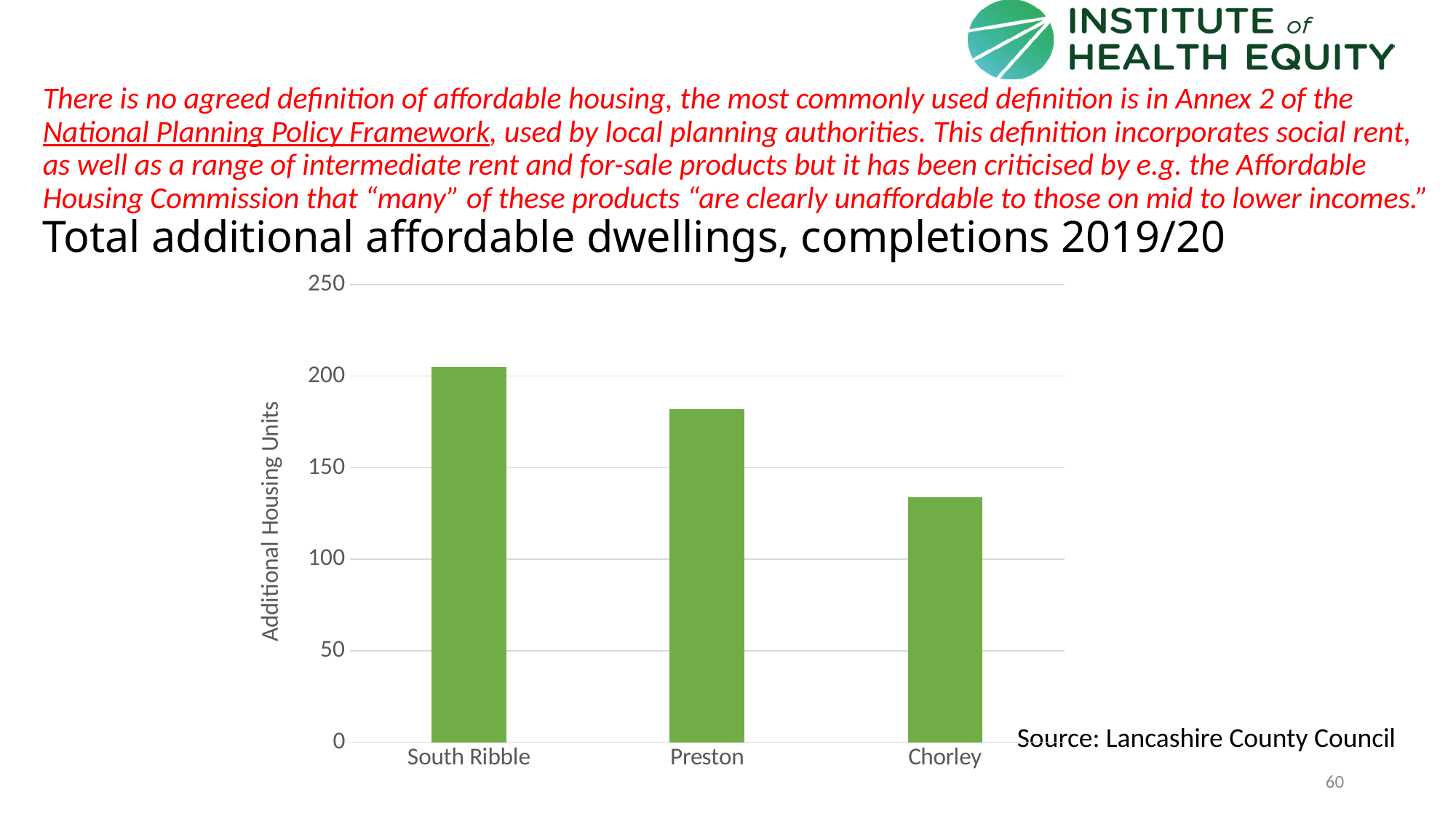
Is the value for Chorley greater or less than 100? greater Is the value for Preston greater or less than 200? less Do the values rise or fall moving from South Ribble to Chorley along the x axis? Fall Which area has the lowest number of total additional affordable dwellings completed in 2019/20? Chorley Is the value for Chorley greater or less than 150? less What type of chart is used on the slide? Bar chart Which has more additional affordable dwellings, South Ribble or Preston? South Ribble Which has more additional affordable dwellings, Preston or Chorley? Preston What is the label on the vertical axis of the chart? Additional Housing Units Which area has the highest number of total additional affordable dwellings completed in 2019/20? South Ribble How many areas are shown in the chart? 3